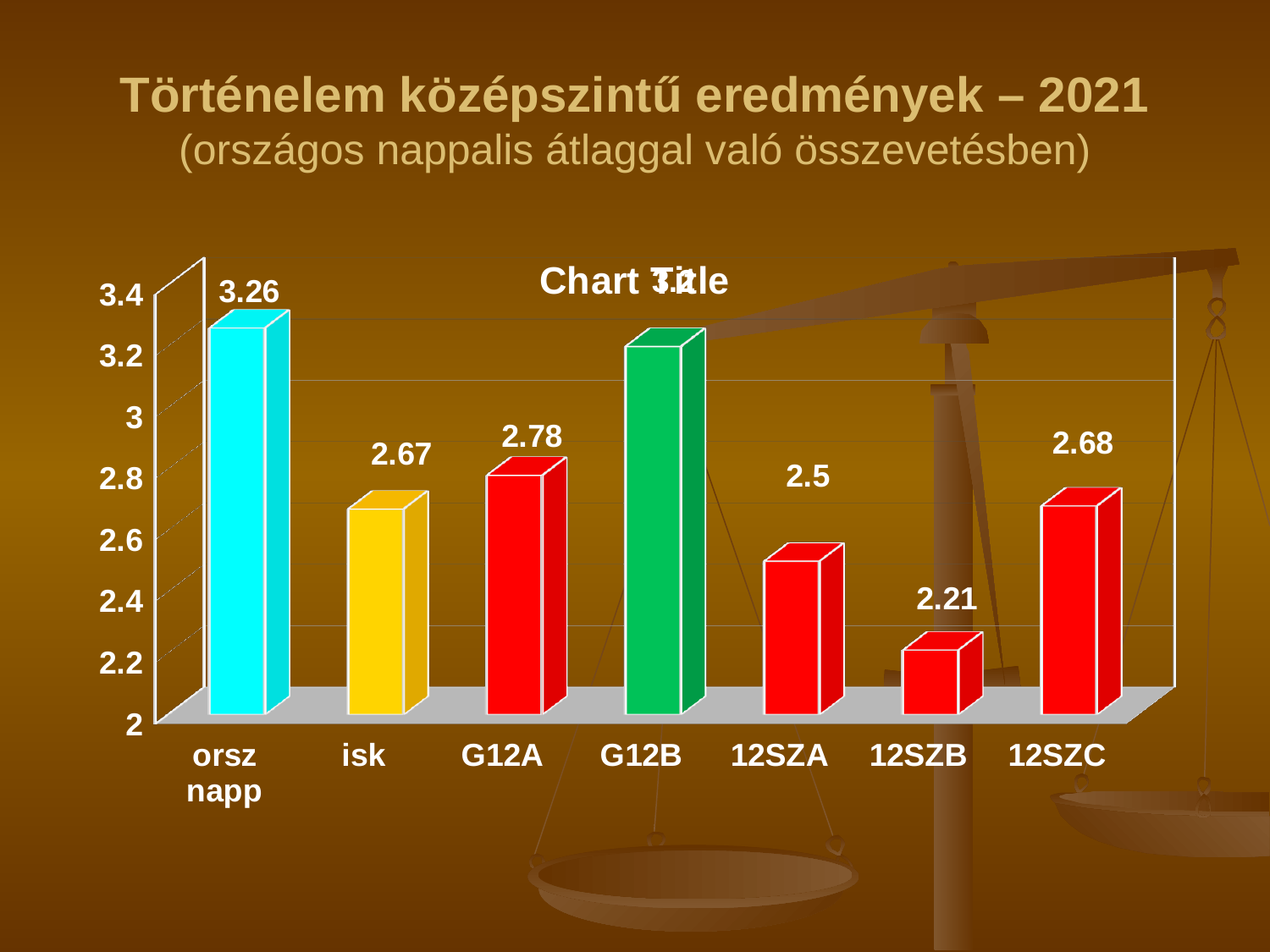
What is the value for G12A? 2.78 What is the value for orsz napp? 3.26 Is the value for G12B greater or less than 3? greater How many categories are shown on the x axis? 7 What is the difference between the values for orsz napp and 12SZB? 1.05 What is the value for isk? 2.67 What is the value for 12SZB? 2.21 What is the difference between the values for G12A and isk? 0.11 What kind of chart is shown on the slide? bar chart Which category has the lowest value? 12SZB Which is larger, the value for G12A or the value for 12SZA? G12A What is the value for 12SZC? 2.68